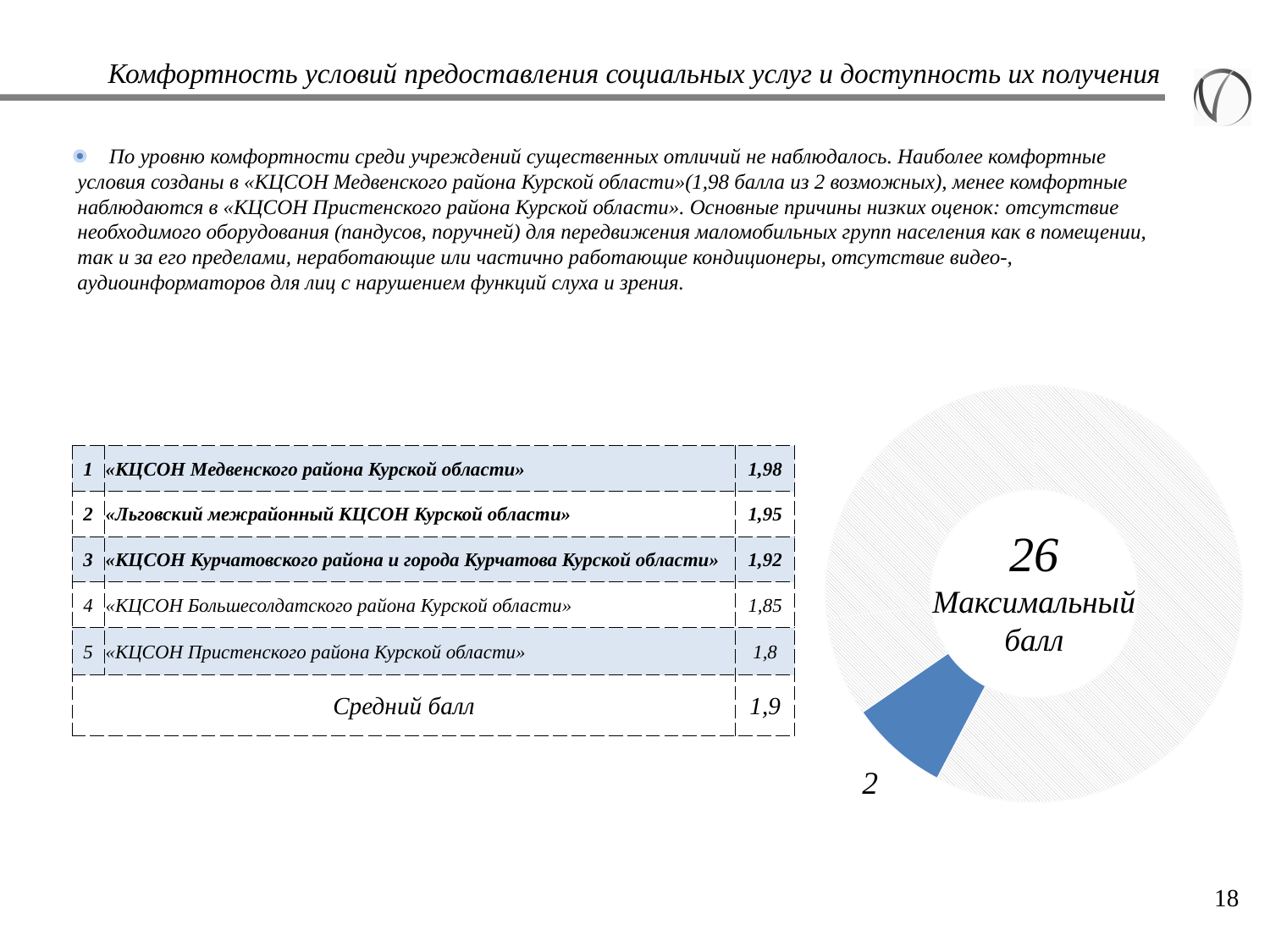
What kind of chart is shown on the right side of the slide? Doughnut (pie) chart What text accompanies the number in the centre of the doughnut chart? Максимальный балл Which slice of the doughnut chart is larger, the blue slice or the hatched slice? The hatched slice What value is printed next to the blue slice of the doughnut chart? 2 What number is shown in the centre of the doughnut chart? 26